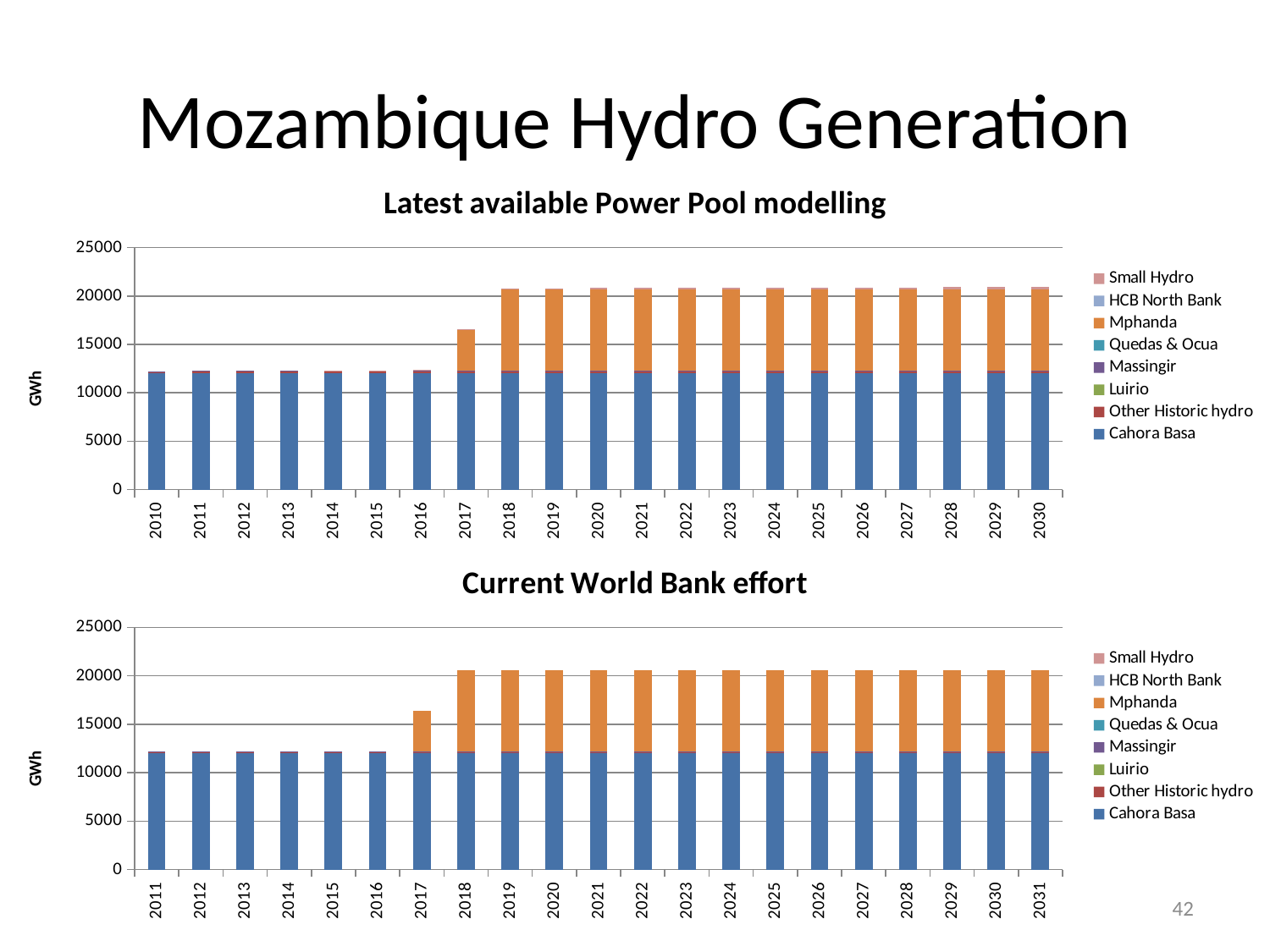
In the 'Latest available Power Pool modelling' chart, is the total bar height for 2018 greater or less than 20000? greater In the 'Current World Bank effort' chart, is the total bar height for 2014 greater or less than 15000? less How many series does the legend of the 'Current World Bank effort' chart list? 8 In the 'Latest available Power Pool modelling' chart, is the total bar height for 2012 greater or less than 15000? less What is the y-axis label on the 'Latest available Power Pool modelling' chart? GWh In the 'Current World Bank effort' chart, do the total bar heights rise or fall from 2016 to 2018? rise What kind of chart is the 'Latest available Power Pool modelling' chart? stacked bar chart In the 'Current World Bank effort' chart, which year has the larger total bar, 2017 or 2018? 2018 In the 'Latest available Power Pool modelling' chart, which year has the larger total bar, 2016 or 2019? 2019 In the 'Current World Bank effort' chart, what is the first year shown on the x axis? 2011 How many years are shown on the x axis of the 'Latest available Power Pool modelling' chart? 21